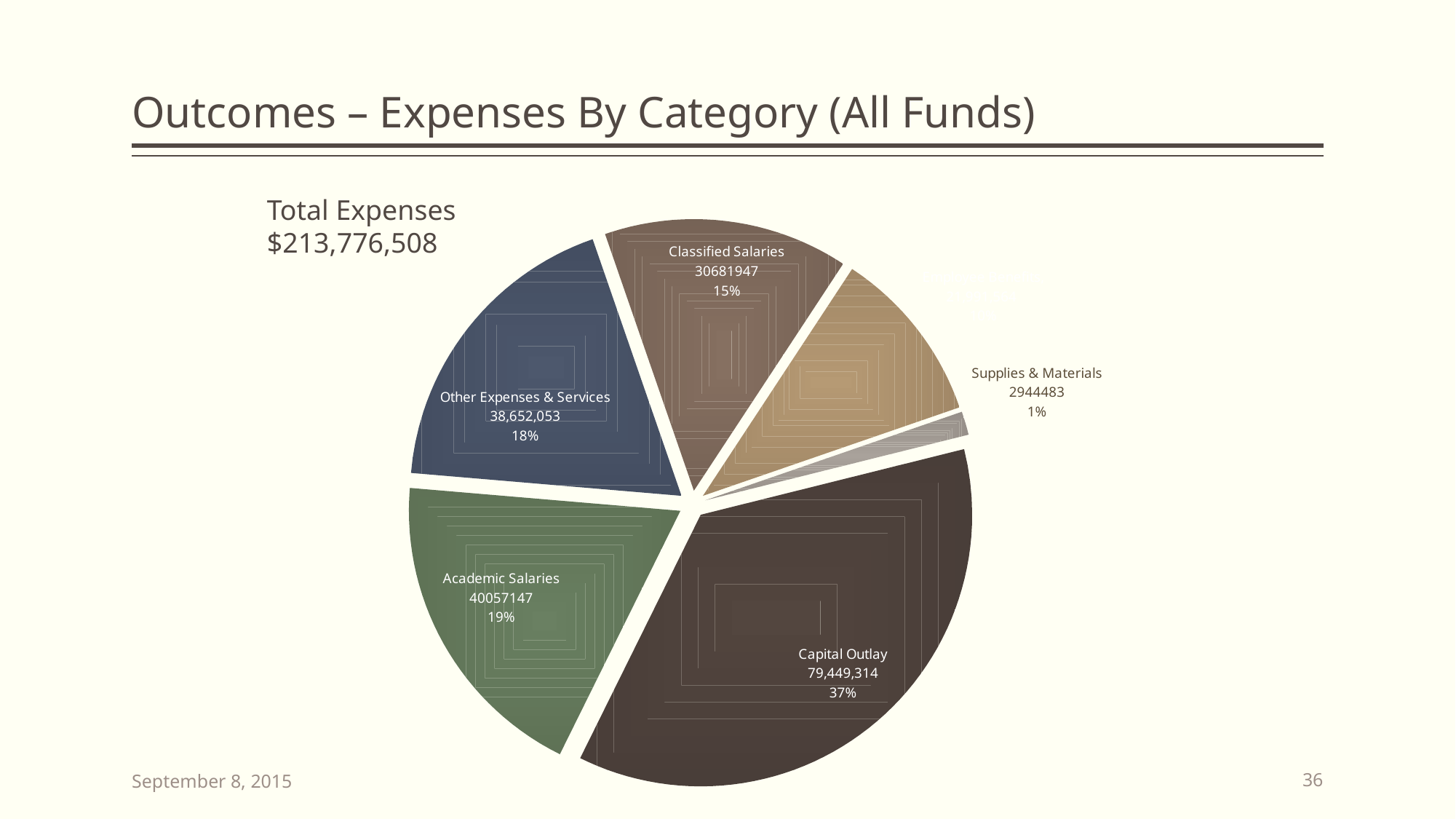
What percentage of the pie is Other Expenses & Services? 18% What percentage of the pie is Classified Salaries? 15% Which is larger, Academic Salaries or Classified Salaries? Academic Salaries What is the difference in percentage points between Capital Outlay and Academic Salaries? 18 What is the value shown for Capital Outlay? 79,449,314 What total expenses figure is printed next to the pie chart? $213,776,508 What kind of chart is shown on the slide? pie chart Which category has the largest slice of the pie? Capital Outlay What percentage of the pie is Academic Salaries? 19% What is the value shown for Supplies & Materials? 2944483 What is the value shown for Classified Salaries? 30681947 Which category has the smallest slice of the pie? Supplies & Materials